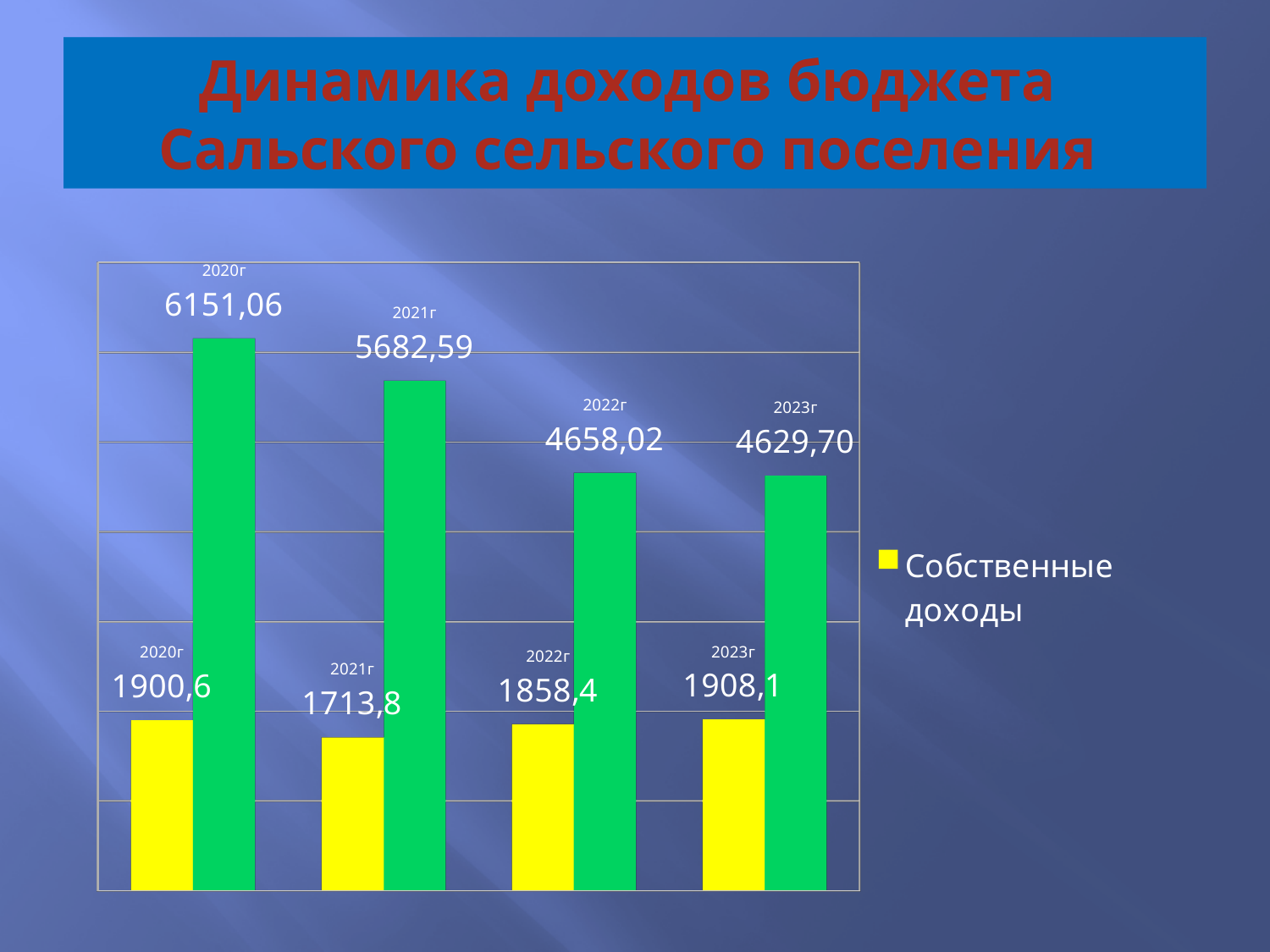
What is the difference between the yellow bar values for 2023г and 2021г? 194,3 In which year is the yellow bar (Собственные доходы) lowest? 2021г What is the value of the green bar for 2022г? 4658,02 What is the value of Собственные доходы (yellow bar) for 2020г? 1900,6 Which is larger: the green bar for 2020г or the green bar for 2021г? 2020г What is the value of the green bar for 2023г? 4629,70 What is the value of Собственные доходы (yellow bar) for 2021г? 1713,8 What is the title of the slide's chart? Динамика доходов бюджета Сальского сельского поселения Do the green bars rise or fall from 2020г to 2023г? fall In which year is the green bar highest? 2020г How many entries does the chart's legend list? 1 What kind of chart is shown on the slide? bar chart